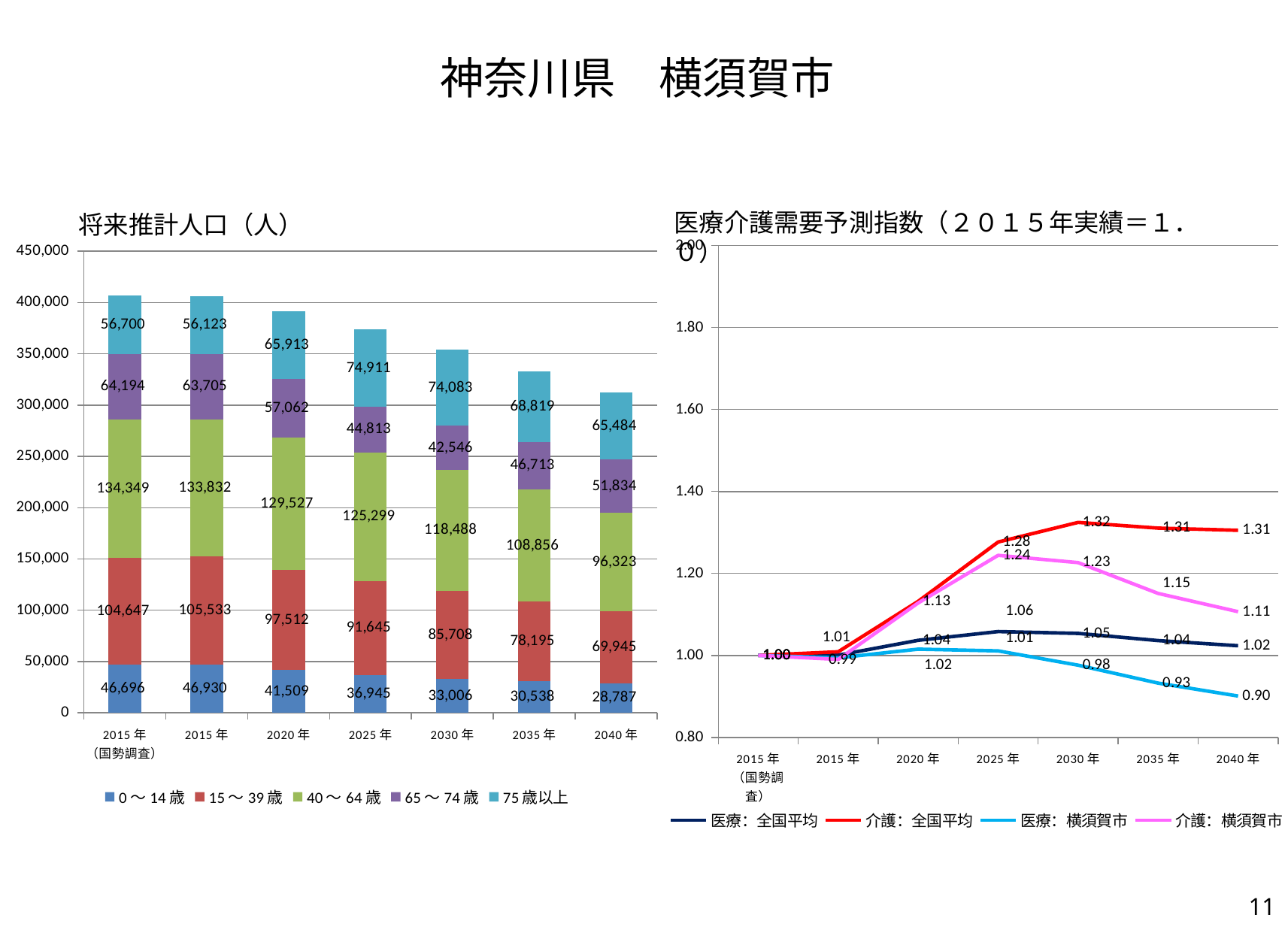
In the left chart 将来推計人口（人）, how many bars are plotted? 7 In the right chart 医療介護需要予測指数, what is the value for 介護：全国平均 in 2030年? 1.32 In the left chart 将来推計人口（人）, does the 0～14歳 value rise or fall from 2020年 to 2040年? fall In the right chart 医療介護需要予測指数, which series has the highest value in 2040年? 介護：全国平均 In the left chart 将来推計人口（人）, what is the value for 40～64歳 in 2025年? 125,299 In the left chart 将来推計人口（人）, what is the value for 75歳以上 in 2040年? 65,484 In the left chart 将来推計人口（人）, what is the difference between the 15～39歳 values for 2015年 and 2040年? 35,588 In the left chart 将来推計人口（人）, what is the value for 0～14歳 in 2015年（国勢調査）? 46,696 In the left chart 将来推計人口（人）, what is the total of the stacked bar for 2040年? 312,373 In the left chart 将来推計人口（人）, how many series does the legend list? 5 In the right chart 医療介護需要予測指数, what is the value for 医療：横須賀市 in 2040年? 0.90 What kind of chart is the right chart 医療介護需要予測指数? line chart